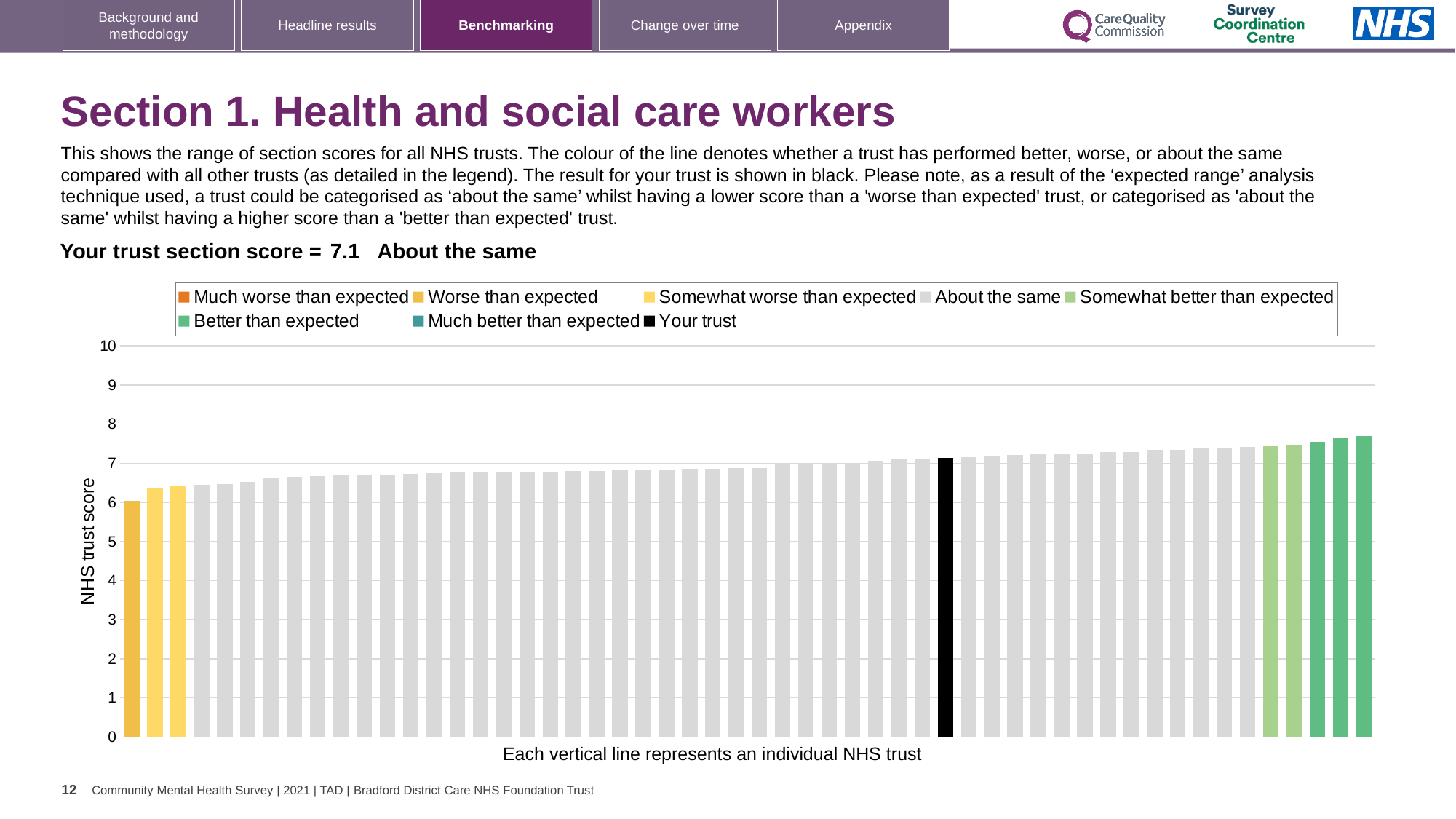
Is the value of the lowest bar (leftmost) greater or less than 5? greater How many entries does the chart legend list? 8 How many bars are coloured yellow at the left of the chart? 3 Is the value of the highest bar (rightmost) greater or less than 8? less What colour is the bar representing your trust? black Is the value of the lowest bar (leftmost) greater or less than 7? less Do the bar values rise or fall from left to right along the x axis? rise What kind of chart is shown on the slide? bar chart What is the section score for your trust shown on the slide? 7.1 What is the label on the y axis of the chart? NHS trust score Which category is your trust's section score placed in? About the same